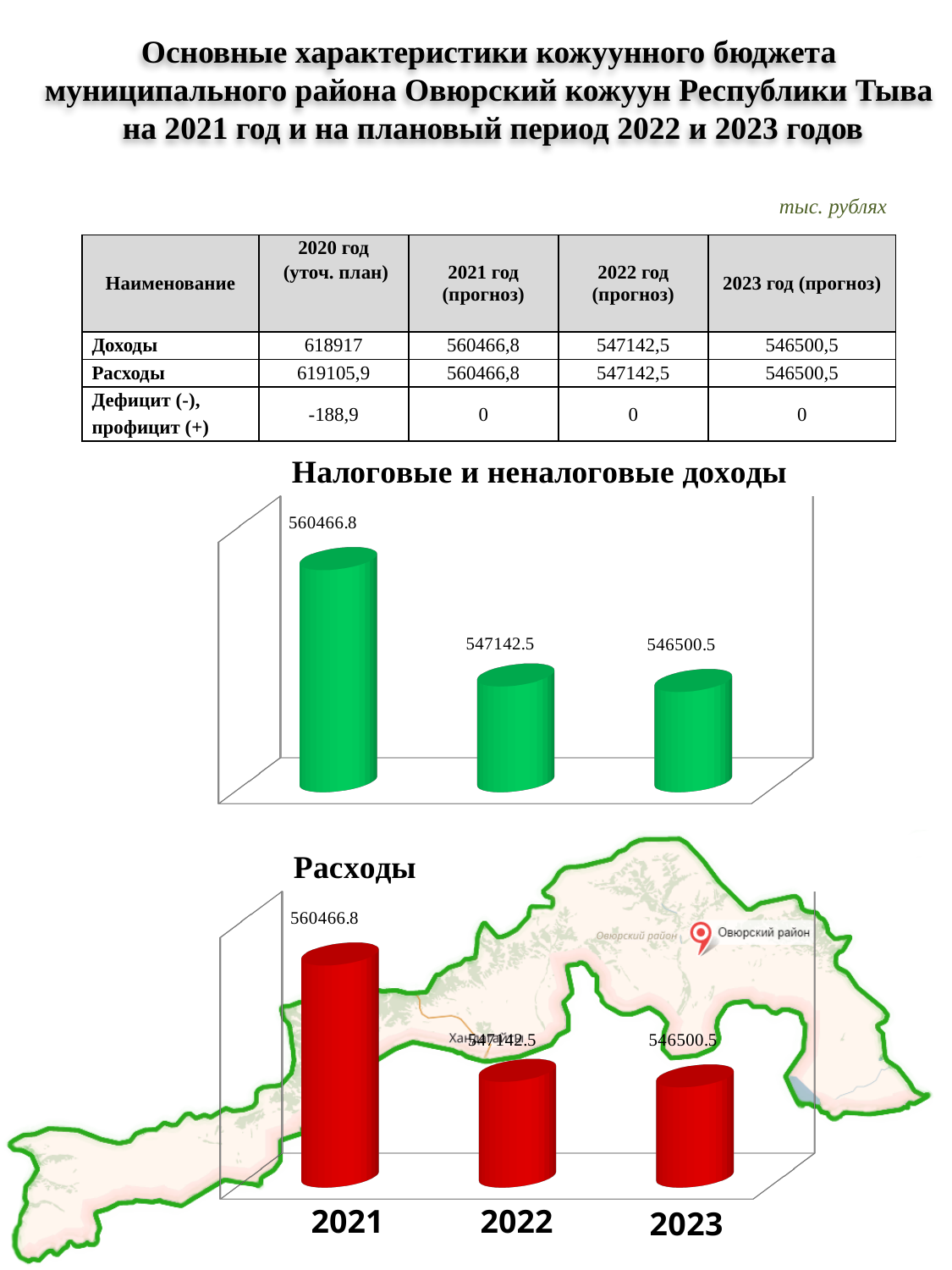
On the chart titled "Налоговые и неналоговые доходы", what is the value of the third (rightmost) bar? 546500.5 On the chart titled "Расходы", do the values rise or fall from 2021 to 2023? Fall What kind of chart is the chart titled "Расходы"? Bar chart On the chart titled "Расходы", what is the value for 2021? 560466.8 On the chart titled "Налоговые и неналоговые доходы", what is the value of the first (leftmost) bar? 560466.8 What colour are the bars on the chart titled "Расходы"? Red On the chart titled "Налоговые и неналоговые доходы", how many bars are plotted? 3 On the chart titled "Расходы", what is the value for 2022? 547142.5 On the chart titled "Расходы", what is the difference between the values for 2021 and 2023? 13966.3 On the chart titled "Расходы", what is the value for 2023? 546500.5 On the chart titled "Расходы", what is the difference between the values for 2021 and 2022? 13324.3 On the chart titled "Расходы", which year has the highest value? 2021